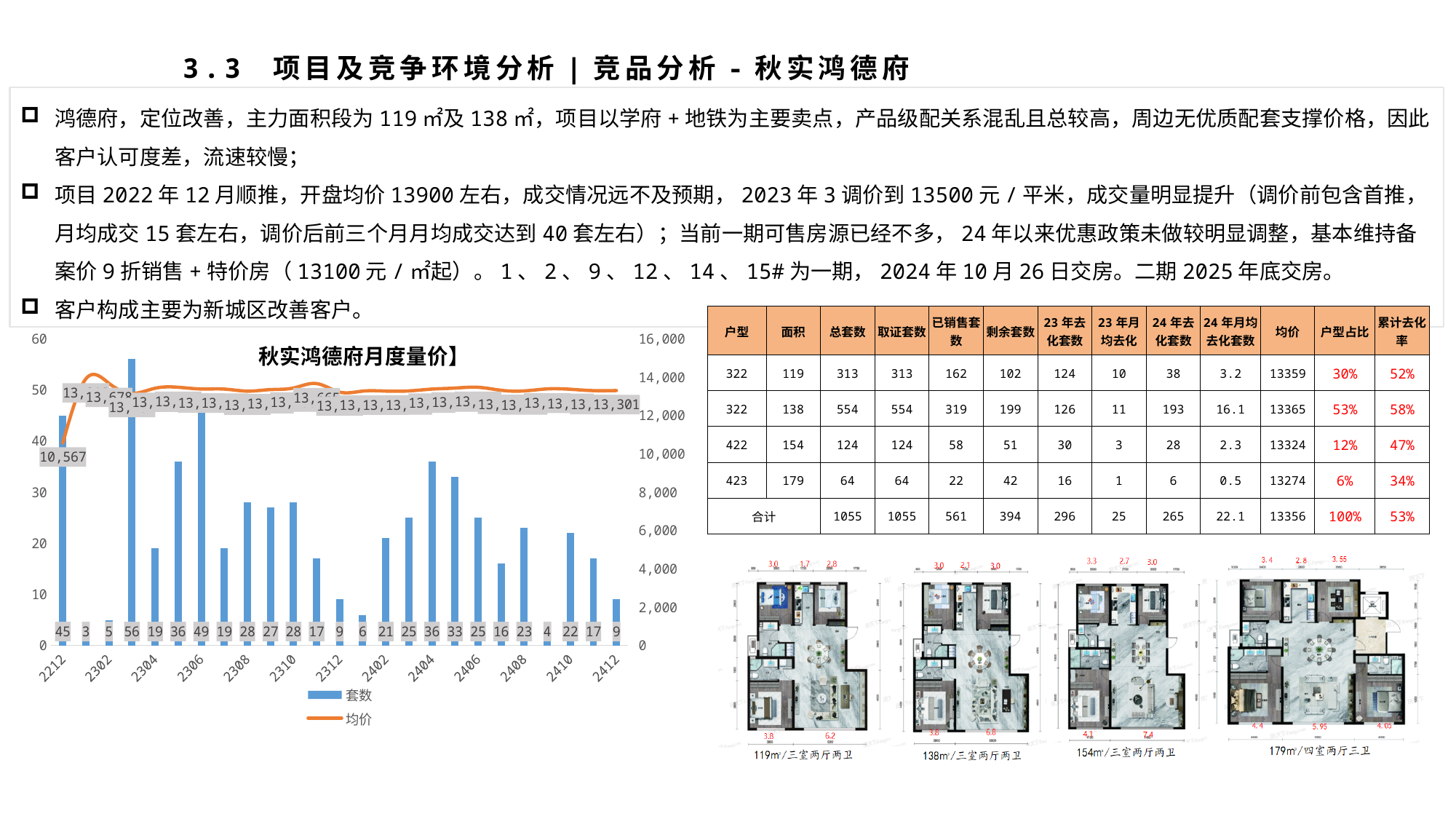
In the 秋实鸿德府月度量价 chart, what is the 套数 value for 2306? 49 In the 秋实鸿德府月度量价 chart, what is the 套数 value for 2212? 45 In the 秋实鸿德府月度量价 chart, what is the highest 套数 value shown on any bar? 56 In the 秋实鸿德府月度量价 chart, what is the lowest 套数 value shown on any bar? 3 In the 秋实鸿德府月度量价 chart, is the 均价 value at 2306 greater or less than 12,000? greater How many series does the legend of the 秋实鸿德府月度量价 chart list? 2 In the 秋实鸿德府月度量价 chart, what is the 套数 value for 2404? 36 In the 秋实鸿德府月度量价 chart, what is the 均价 value labelled at 2212? 10,567 In the 秋实鸿德府月度量价 chart, what is the 均价 value labelled at 2412? 13,301 What kind of chart is the 秋实鸿德府月度量价 chart? A combined bar and line chart In the 秋实鸿德府月度量价 chart, which month has the larger 套数, 2306 or 2308? 2306 In the 秋实鸿德府月度量价 chart, what is the difference between the 套数 for 2212 and the 套数 for 2412? 36